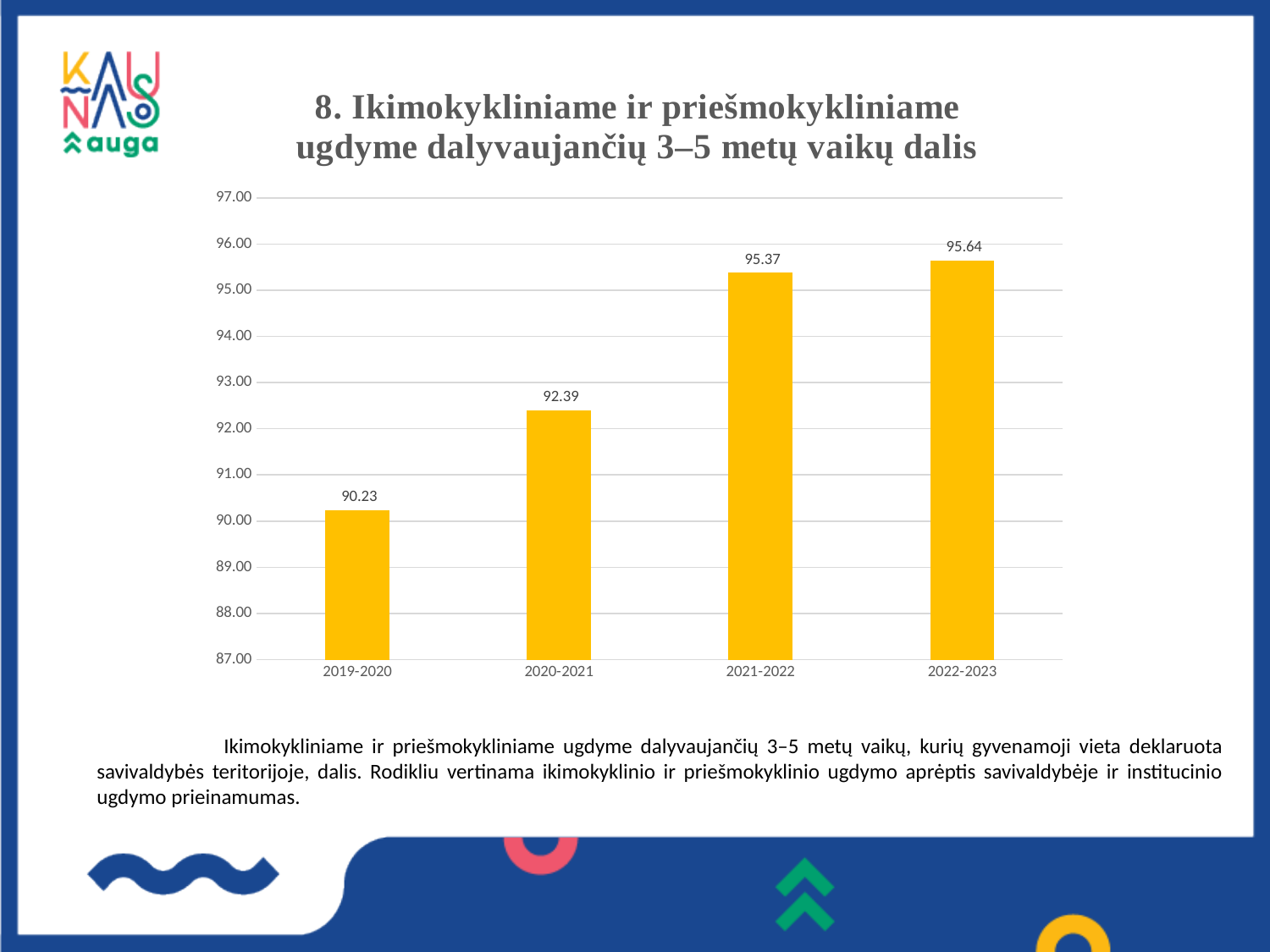
What is the value for 2021-2022? 95.37 What is the value for 2020-2021? 92.39 Which is larger, the value for 2020-2021 or the value for 2019-2020? 2020-2021 What is the value for 2019-2020? 90.23 What is the difference between the values for 2022-2023 and 2019-2020? 5.41 What is the value for 2022-2023? 95.64 How many periods are shown on the x axis? 4 What is the difference between the values for 2021-2022 and 2020-2021? 2.98 Which period has the lowest value? 2019-2020 What kind of chart is shown on the slide? bar chart Do the values rise or fall from 2019-2020 to 2022-2023? rise Which period has the highest value? 2022-2023